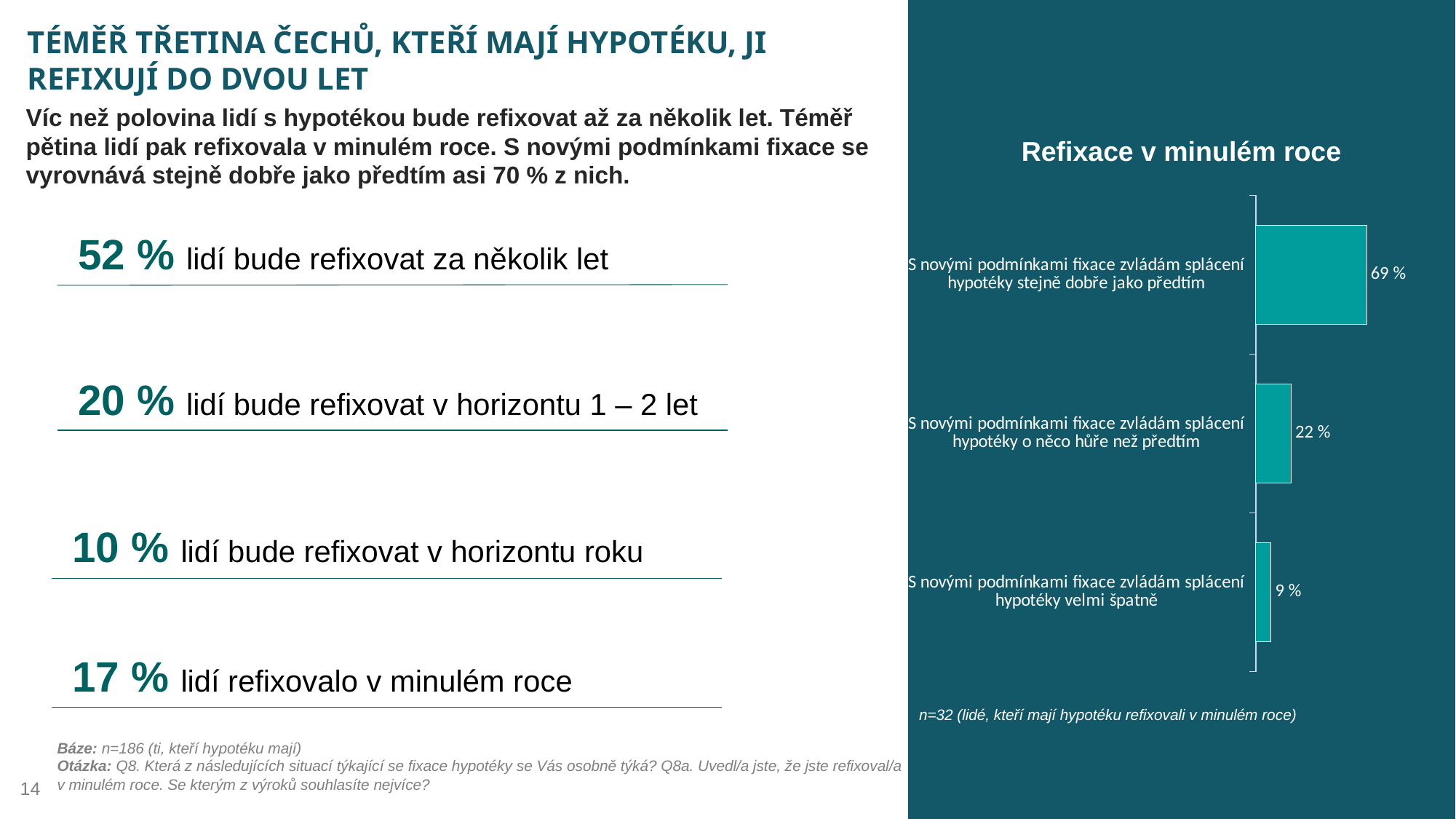
Which category has the lowest value in the chart? S novými podmínkami fixace zvládám splácení hypotéky velmi špatně What is the value for "S novými podmínkami fixace zvládám splácení hypotéky velmi špatně"? 9 % What sample size (n) is stated below the chart? n=32 What is the title of the chart on the slide? Refixace v minulém roce What is the value for "S novými podmínkami fixace zvládám splácení hypotéky o něco hůře než předtím"? 22 % Which category has the highest value in the chart? S novými podmínkami fixace zvládám splácení hypotéky stejně dobře jako předtím Which is larger: the value for "o něco hůře než předtím" or the value for "velmi špatně"? o něco hůře než předtím How many categories does the chart show? 3 What is the value for "S novými podmínkami fixace zvládám splácení hypotéky stejně dobře jako předtím"? 69 % What is the difference between the value for "stejně dobře jako předtím" and the value for "o něco hůře než předtím"? 47 % What type of chart is shown on the slide? bar chart What is the difference between the value for "o něco hůře než předtím" and the value for "velmi špatně"? 13 %